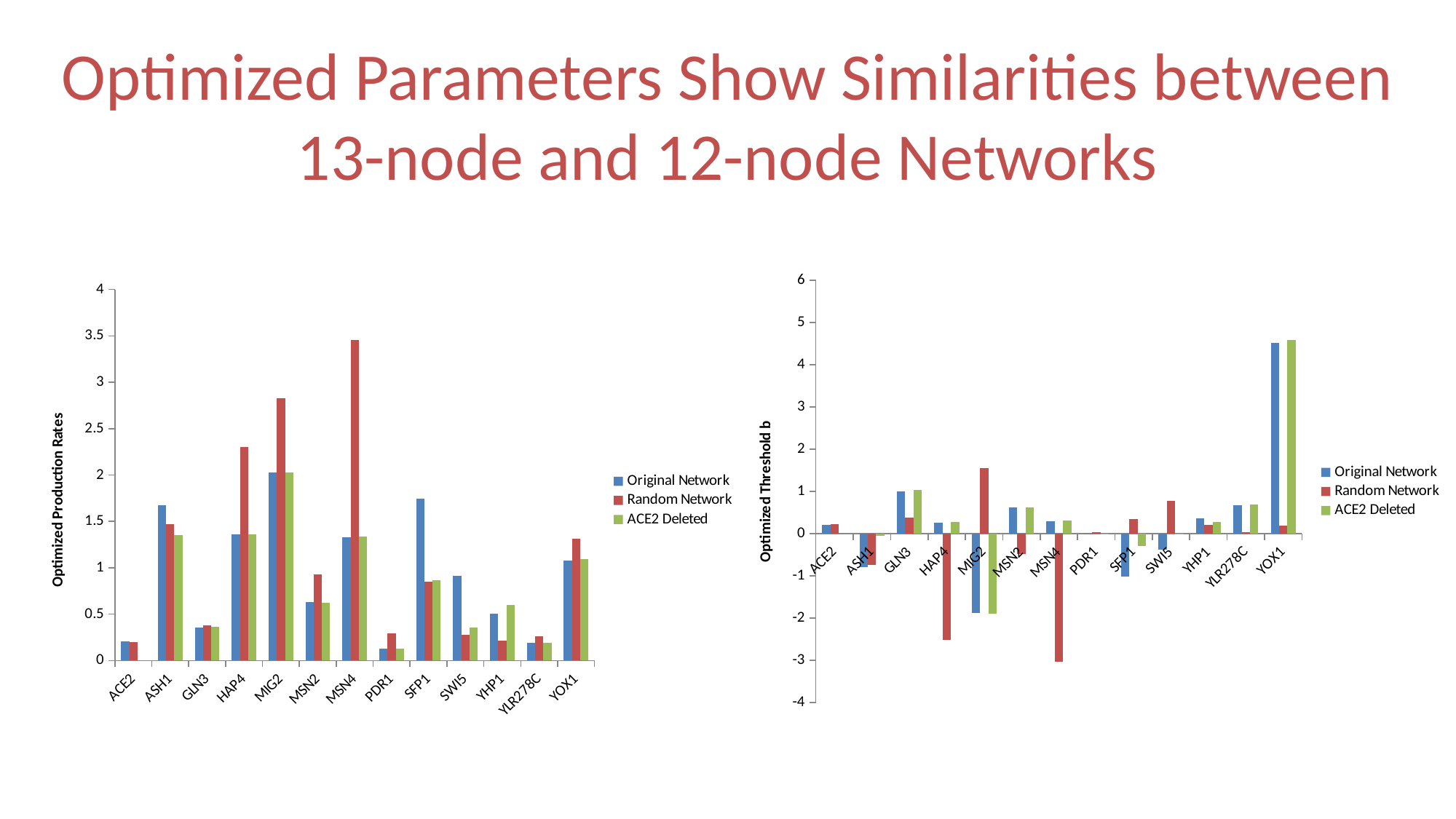
In the right chart (Optimized Threshold b), which category has the lowest Random Network value? MSN4 In the right chart (Optimized Threshold b), is the Random Network value for HAP4 greater or less than -2? less In the left chart (Optimized Production Rates), which category has the highest Original Network value? MIG2 What kind of chart is the left chart (Optimized Production Rates)? bar chart In the left chart (Optimized Production Rates), is the Random Network value for MSN4 greater or less than 3? greater In the left chart (Optimized Production Rates), is the Original Network value for SFP1 greater or less than 1.5? greater What is the y-axis title of the right chart? Optimized Threshold b In the left chart (Optimized Production Rates), which category has the highest Random Network value? MSN4 How many categories are shown on the x axis of the left chart (Optimized Production Rates)? 13 In the right chart (Optimized Threshold b), which category has the highest Original Network value? YOX1 How many series does the legend of the right chart (Optimized Threshold b) list? 3 In the left chart (Optimized Production Rates), which is larger for HAP4: the Original Network value or the Random Network value? Random Network